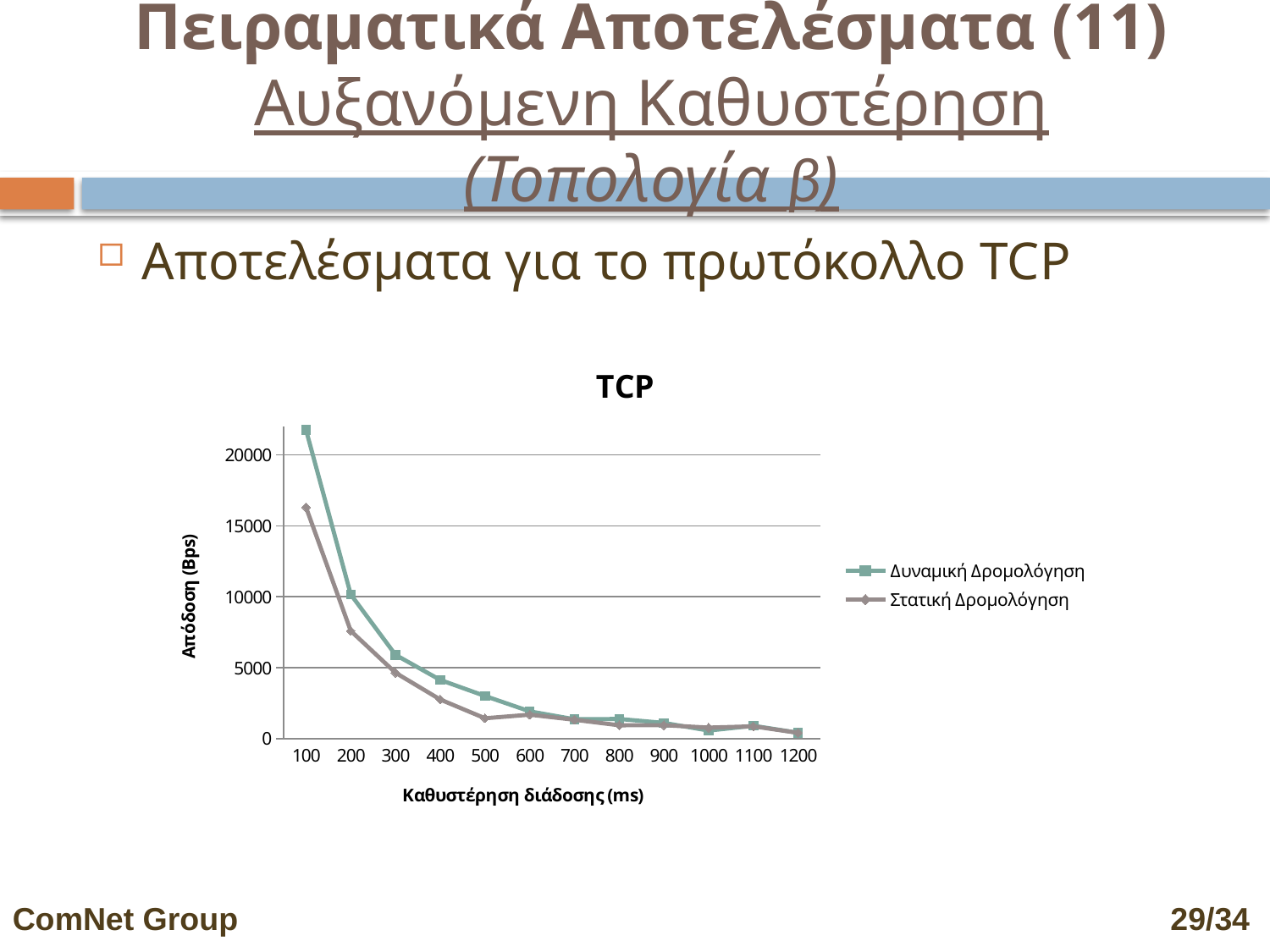
At which propagation delay does Δυναμική Δρομολόγηση reach its highest value? 100 What kind of chart is shown on the slide? line chart How many x-axis points (delay values) are plotted in the TCP chart? 12 Is the value for Δυναμική Δρομολόγηση at 400 ms greater or less than 5000? less Do the values of Δυναμική Δρομολόγηση rise or fall as the propagation delay increases? fall Is the value for Στατική Δρομολόγηση at 200 ms greater or less than 10000? less Is the value for Στατική Δρομολόγηση at 100 ms greater or less than 20000? less How many series does the legend of the TCP chart list? 2 What is the title of the chart? TCP What is the label of the y axis of the chart? Απόδοση (Bps) At 100 ms, which series has the higher value, Δυναμική Δρομολόγηση or Στατική Δρομολόγηση? Δυναμική Δρομολόγηση